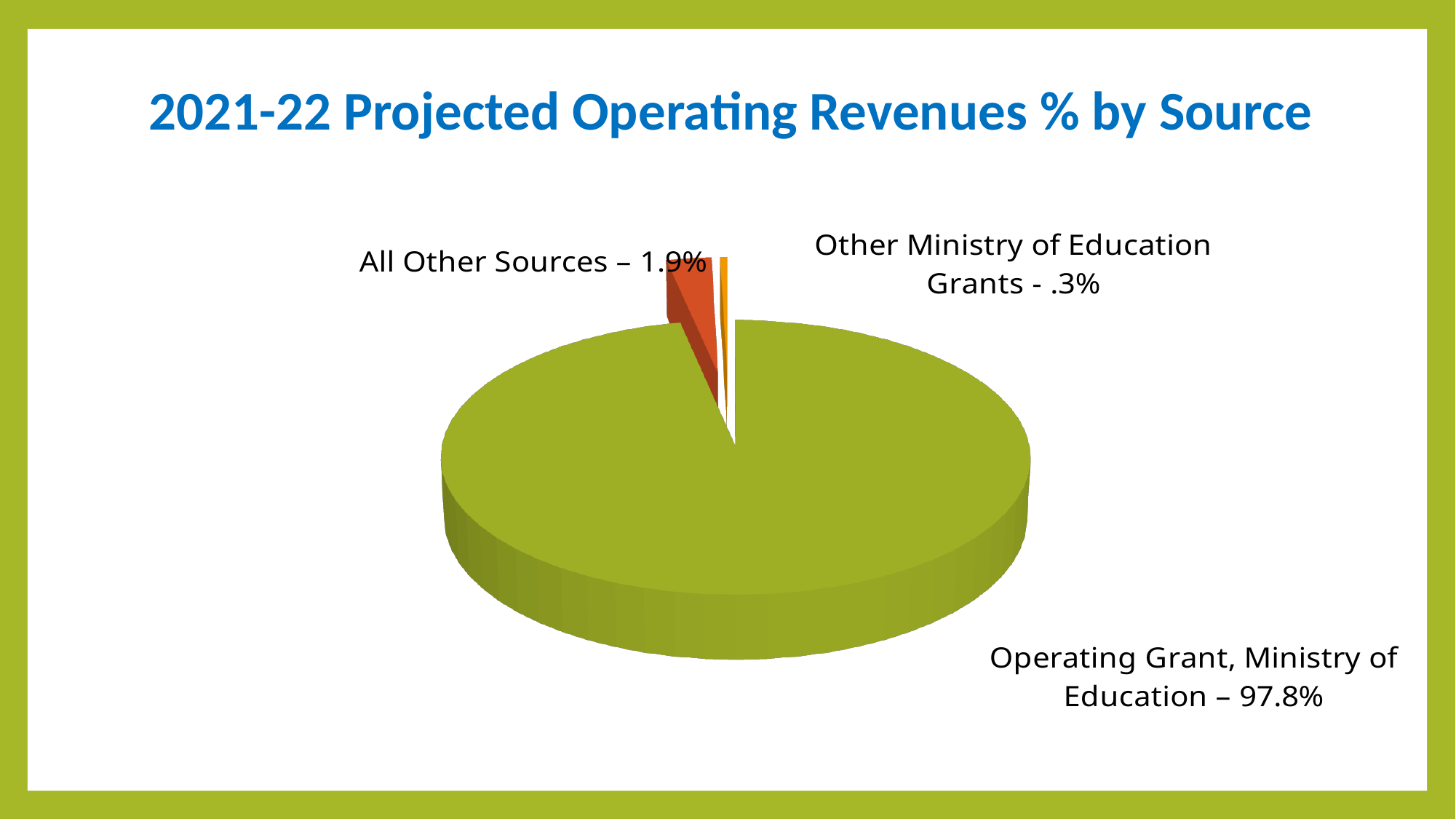
What share of projected operating revenues comes from Other Ministry of Education Grants? .3% What is the title of the chart on the slide? 2021-22 Projected Operating Revenues % by Source What colour is the slice for the Operating Grant, Ministry of Education? green What is the difference in percentage points between the All Other Sources share and the Other Ministry of Education Grants share? 1.6 Which source accounts for the smallest share of projected operating revenues? Other Ministry of Education Grants Which source accounts for the largest share of projected operating revenues? Operating Grant, Ministry of Education What kind of chart is shown on the slide? pie chart What share of projected operating revenues comes from All Other Sources? 1.9% What is the difference in percentage points between the Operating Grant, Ministry of Education share and the All Other Sources share? 95.9 What share of projected operating revenues comes from the Operating Grant, Ministry of Education? 97.8% How many sources (slices) are shown in the pie chart? 3 Which is larger: the share for All Other Sources or the share for Other Ministry of Education Grants? All Other Sources